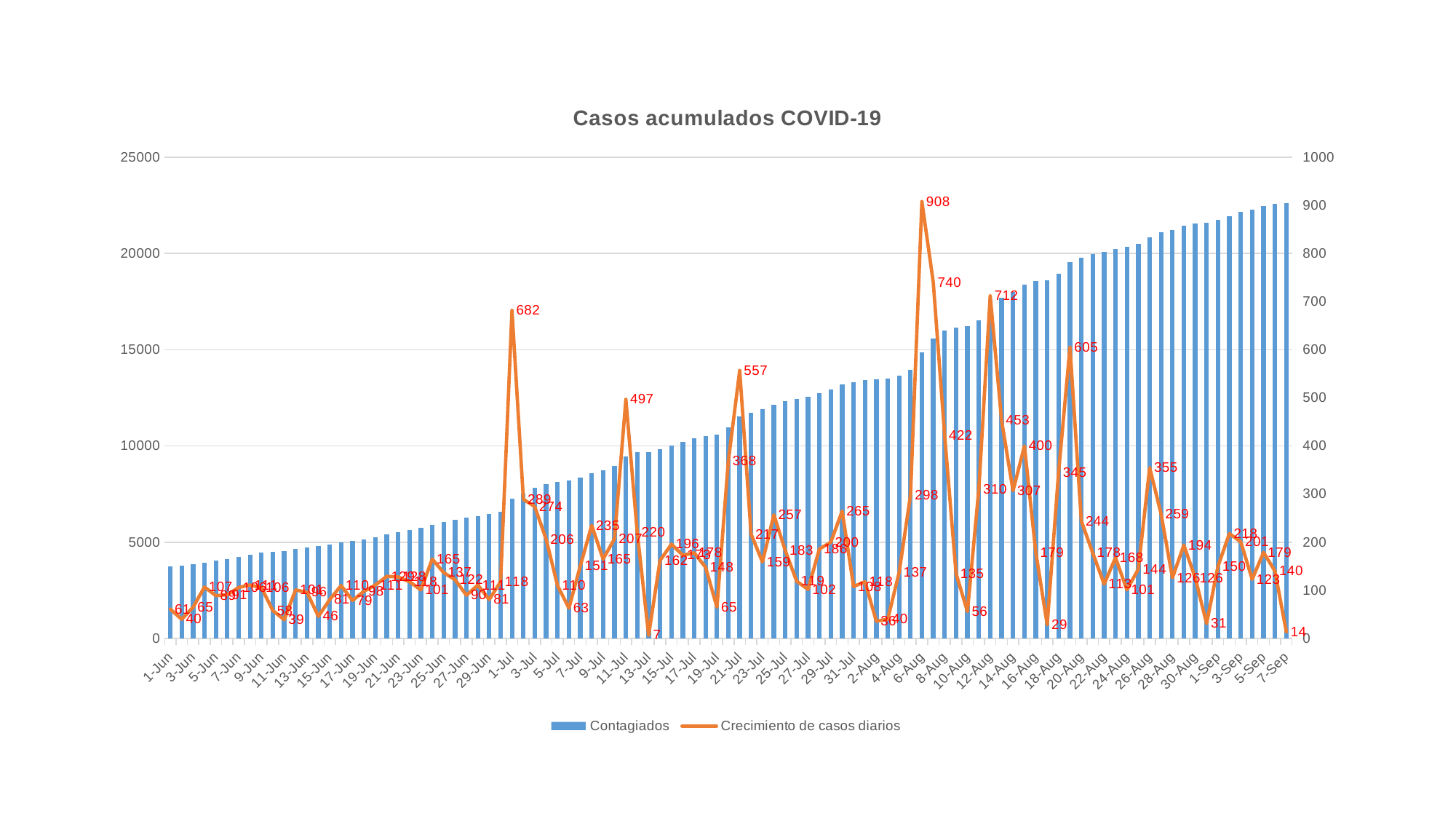
What is the lowest value of the Crecimiento de casos diarios line? 7 On which date does the Crecimiento de casos diarios line reach its highest value? 6-Aug Is the Contagiados value for 7-Sep greater or less than 20000? greater What is the value of Crecimiento de casos diarios on 7-Sep? 14 What kind of chart is this? Combined bar and line chart What is the title of the chart? Casos acumulados COVID-19 How many series does the legend list? 2 What is the value of Crecimiento de casos diarios on 1-Jul? 682 Do the Contagiados bars rise or fall from 1-Jun to 7-Sep? rise What is the highest value of the Crecimiento de casos diarios line? 908 Which is larger, the Crecimiento de casos diarios value on 1-Jul or on 21-Jul? 1-Jul